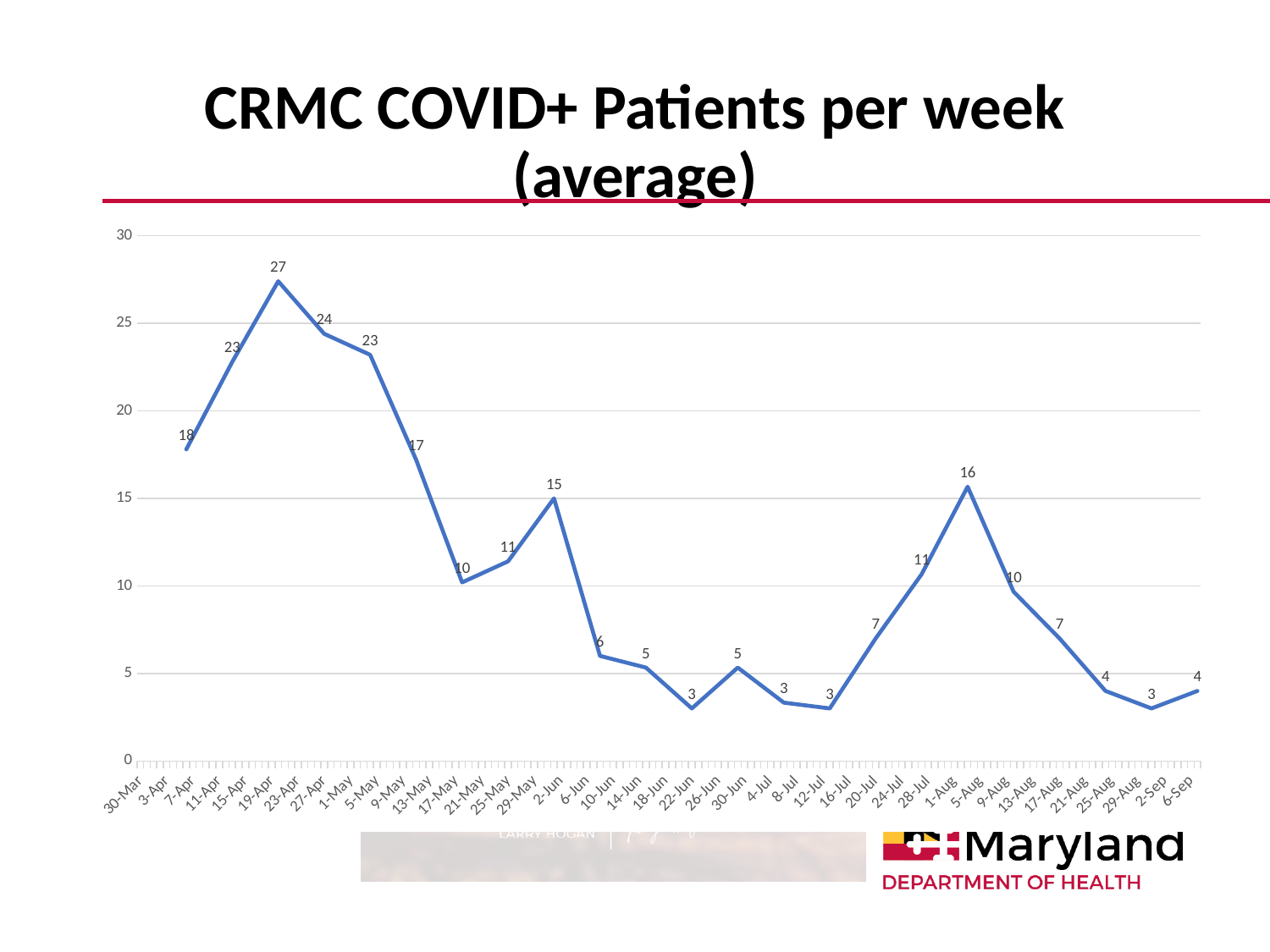
What is the value at the second, smaller peak in early August? 16 What is the value of the last data point on the line (early September)? 4 What is the value of the first data point on the line (early April)? 18 What is the difference between the first data point (18) and the last data point (4)? 14 What type of chart is shown on the slide? line chart What is the lowest value plotted on the line? 3 How many data points are plotted on the line? 23 Does the line rise or fall between the first data point and the April peak? rise What is the difference between the highest peak (27) and the early-August peak (16)? 11 What is the title of the chart? CRMC COVID+ Patients per week (average) What is the highest value plotted on the line? 27 Which is larger: the early-June peak or the early-August peak? the early-August peak (16)